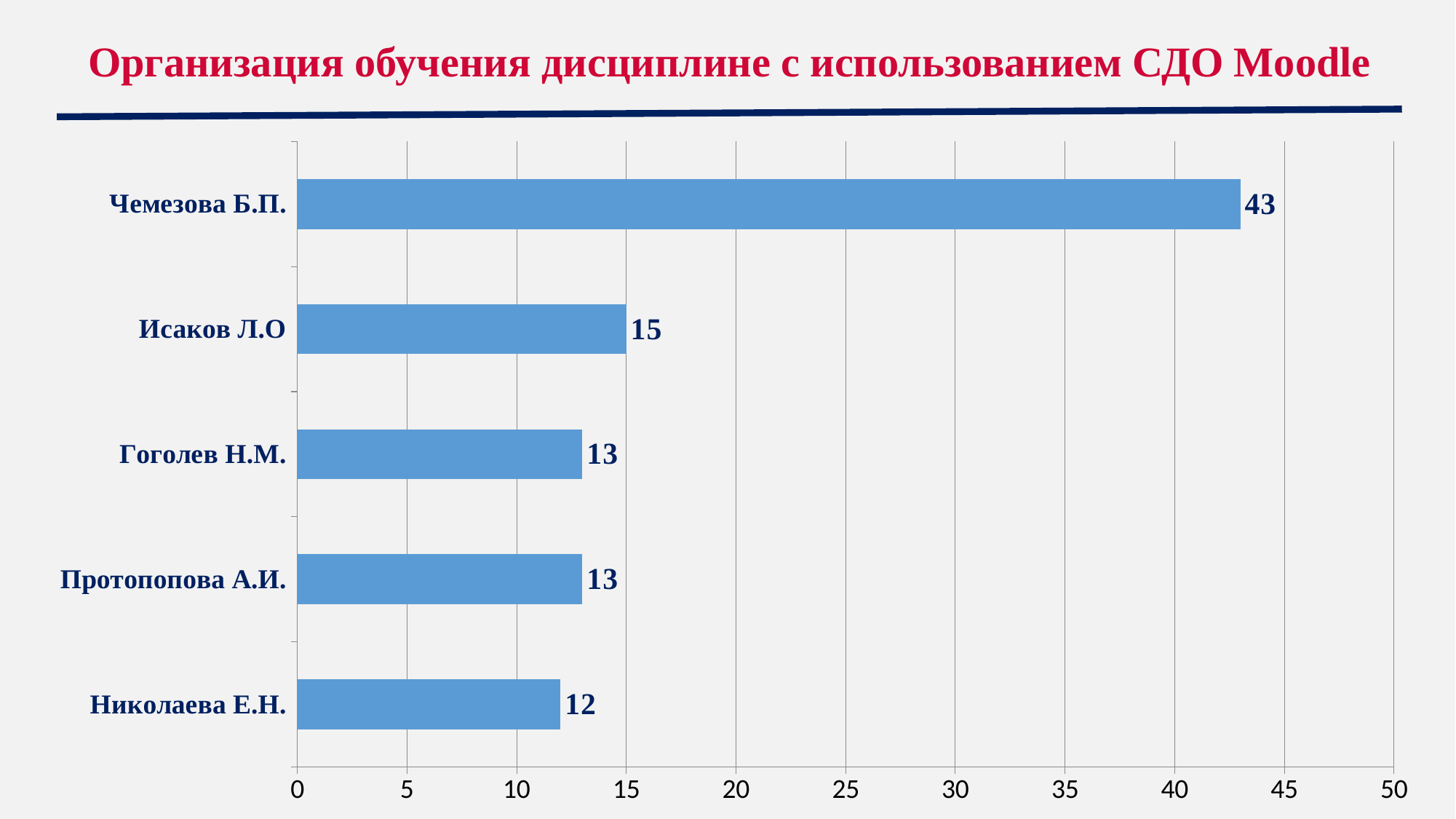
What is the difference between the values for Протопопова А.И. and Николаева Е.Н.? 1 What is the value for Гоголев Н.М.? 13 Is the value for Чемезова Б.П. greater or less than 40? greater Which is larger, the value for Исаков Л.О or the value for Гоголев Н.М.? Исаков Л.О What is the difference between the values for Чемезова Б.П. and Исаков Л.О? 28 How many categories are shown in the chart? 5 What kind of chart is shown on the slide? bar chart Which category has the highest value? Чемезова Б.П. Which category has the lowest value? Николаева Е.Н. What is the value for Исаков Л.О? 15 What is the value for Николаева Е.Н.? 12 What is the value for Чемезова Б.П.? 43